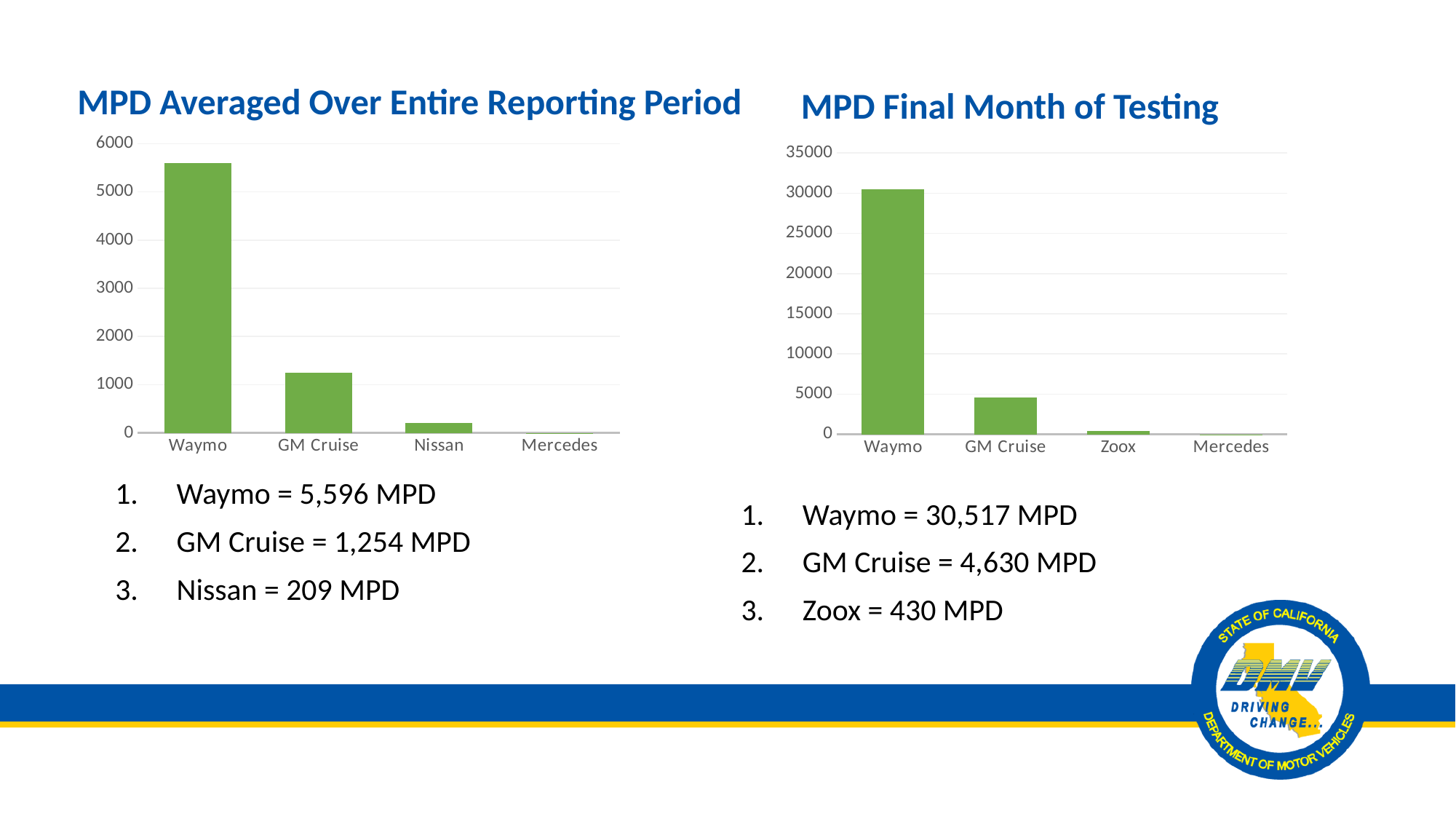
In the 'MPD Averaged Over Entire Reporting Period' chart, what is the difference between the Waymo and GM Cruise values? 4,342 MPD In the 'MPD Averaged Over Entire Reporting Period' chart, is the value for Nissan greater or less than 1000? less In the 'MPD Averaged Over Entire Reporting Period' chart, what is the value for Waymo? 5,596 MPD What kind of chart is the 'MPD Averaged Over Entire Reporting Period' chart? Bar chart In the 'MPD Final Month of Testing' chart, what is the difference between the GM Cruise and Zoox values? 4,200 MPD In the 'MPD Averaged Over Entire Reporting Period' chart, which category has the highest value? Waymo In the 'MPD Final Month of Testing' chart, what is the value for Waymo? 30,517 MPD In the 'MPD Final Month of Testing' chart, which is larger, GM Cruise or Zoox? GM Cruise In the 'MPD Averaged Over Entire Reporting Period' chart, what is the value for GM Cruise? 1,254 MPD In the 'MPD Final Month of Testing' chart, which category has the lowest value? Mercedes How many categories are shown on the x axis of the 'MPD Final Month of Testing' chart? 4 In the 'MPD Final Month of Testing' chart, what is the value for Zoox? 430 MPD